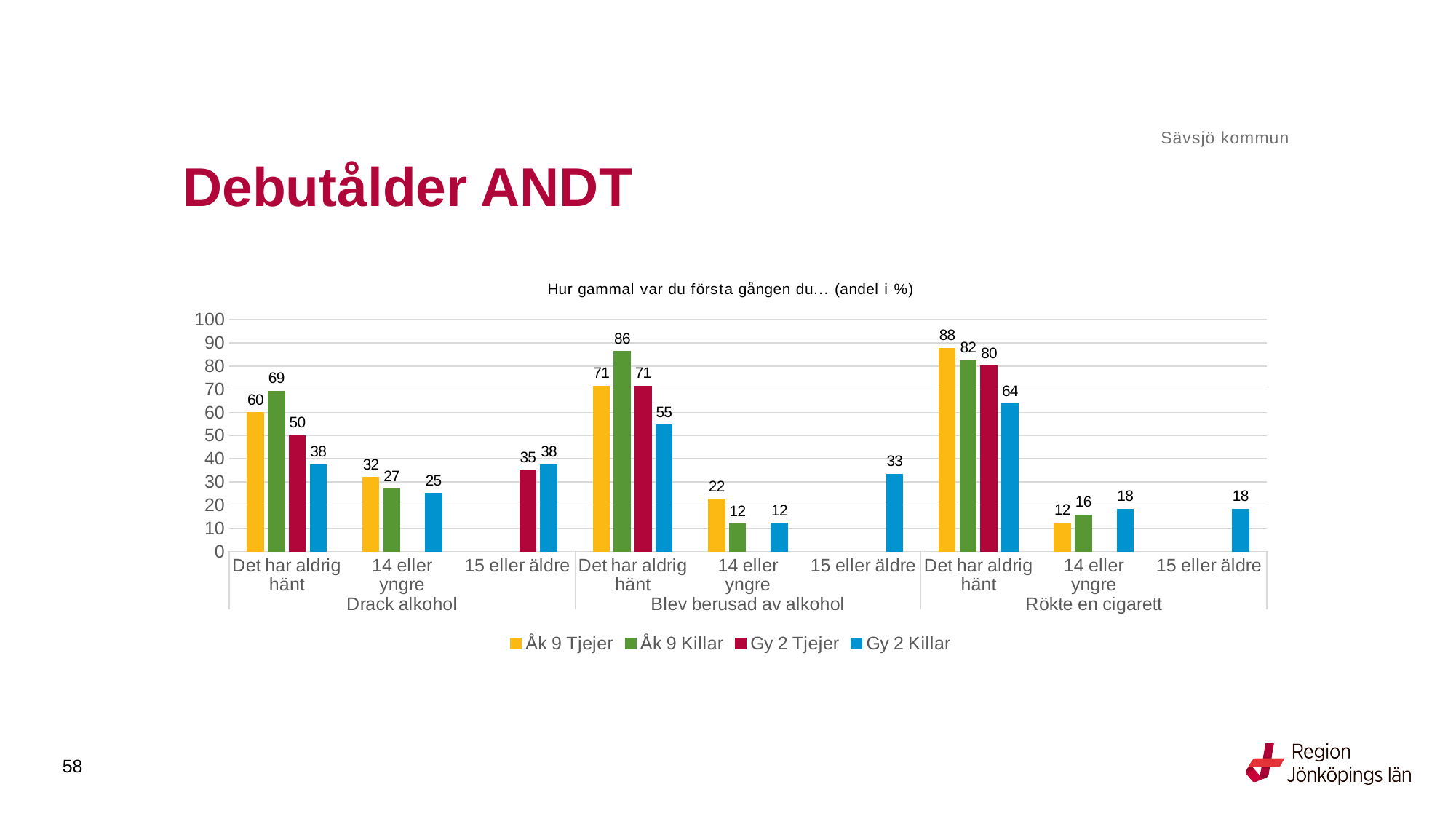
What is the difference between Åk 9 Tjejer and Gy 2 Killar under 'Det har aldrig hänt' in the 'Rökte en cigarett' group? 24 Which series has the highest value under 'Det har aldrig hänt' in the 'Blev berusad av alkohol' group? Åk 9 Killar How many series does the legend list? 4 What colour represents Gy 2 Killar in the chart? Blue What kind of chart is shown on the slide? Bar chart What is the value for Åk 9 Tjejer under 'Det har aldrig hänt' in the 'Rökte en cigarett' group? 88 Is the value for Gy 2 Killar under 'Det har aldrig hänt' in the 'Blev berusad av alkohol' group greater or less than 50? greater What is the value for Åk 9 Killar under 'Det har aldrig hänt' in the 'Drack alkohol' group? 69 Under '14 eller yngre' in the 'Drack alkohol' group, which is larger: Åk 9 Tjejer or Åk 9 Killar? Åk 9 Tjejer What is the title of the chart? Hur gammal var du första gången du… (andel i %) Which series has the lowest value under 'Det har aldrig hänt' in the 'Drack alkohol' group? Gy 2 Killar What is the value for Gy 2 Killar under '15 eller äldre' in the 'Blev berusad av alkohol' group? 33